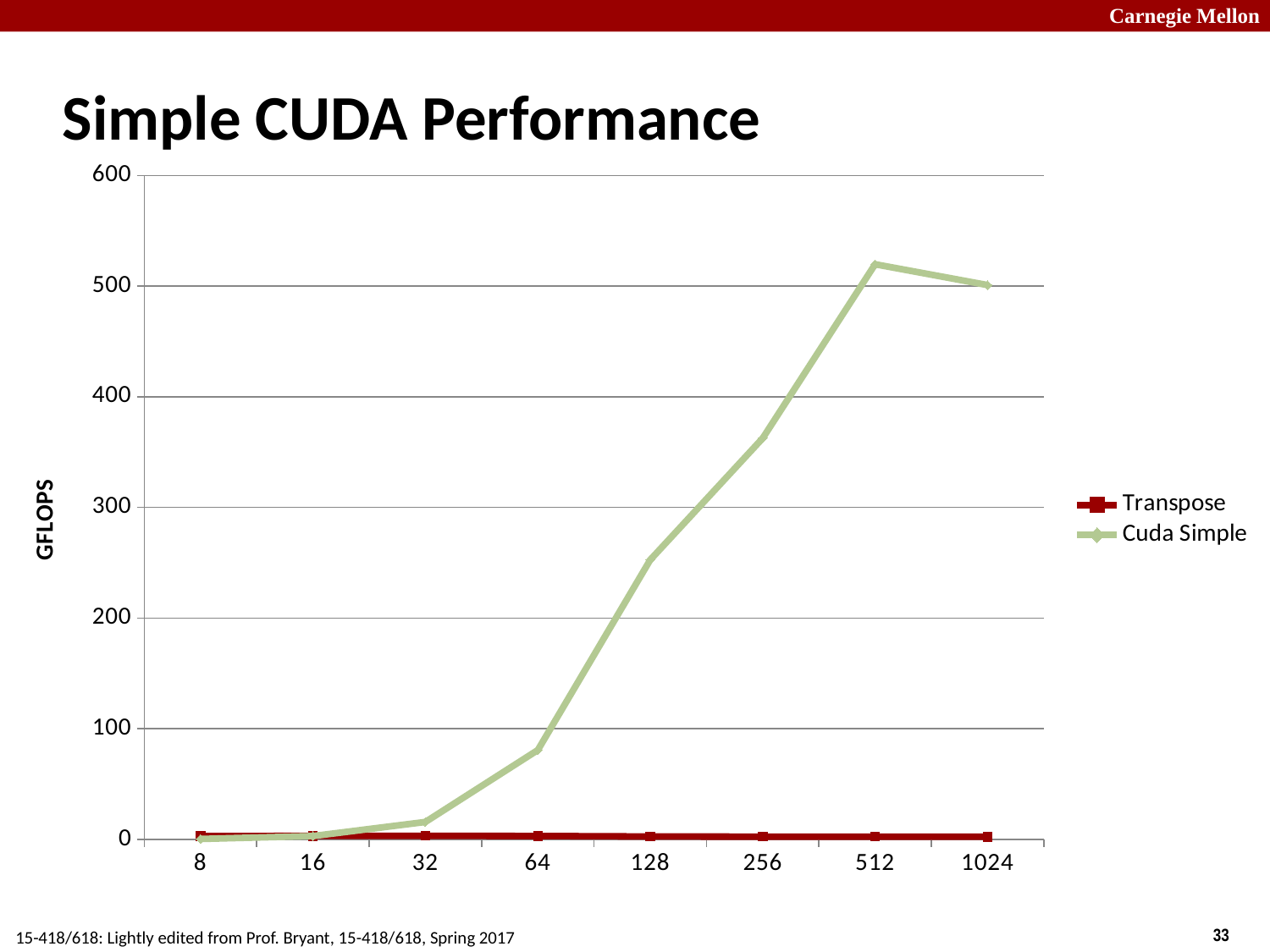
What kind of chart is shown on the slide? line chart Is the Cuda Simple value at 512 greater or less than 400? greater At 512, which series has the larger value, Transpose or Cuda Simple? Cuda Simple How many series does the legend list? 2 What is the label on the y axis? GFLOPS Is the Cuda Simple value at 64 greater or less than 100? less Is the Transpose value at 1024 greater or less than 100? less At which x-axis value does the Cuda Simple series reach its highest point? 512 At which x-axis value is the Cuda Simple series lowest? 8 Does the Cuda Simple series rise or fall between 8 and 512 along the x axis? rise How many x-axis categories are plotted on the chart? 8